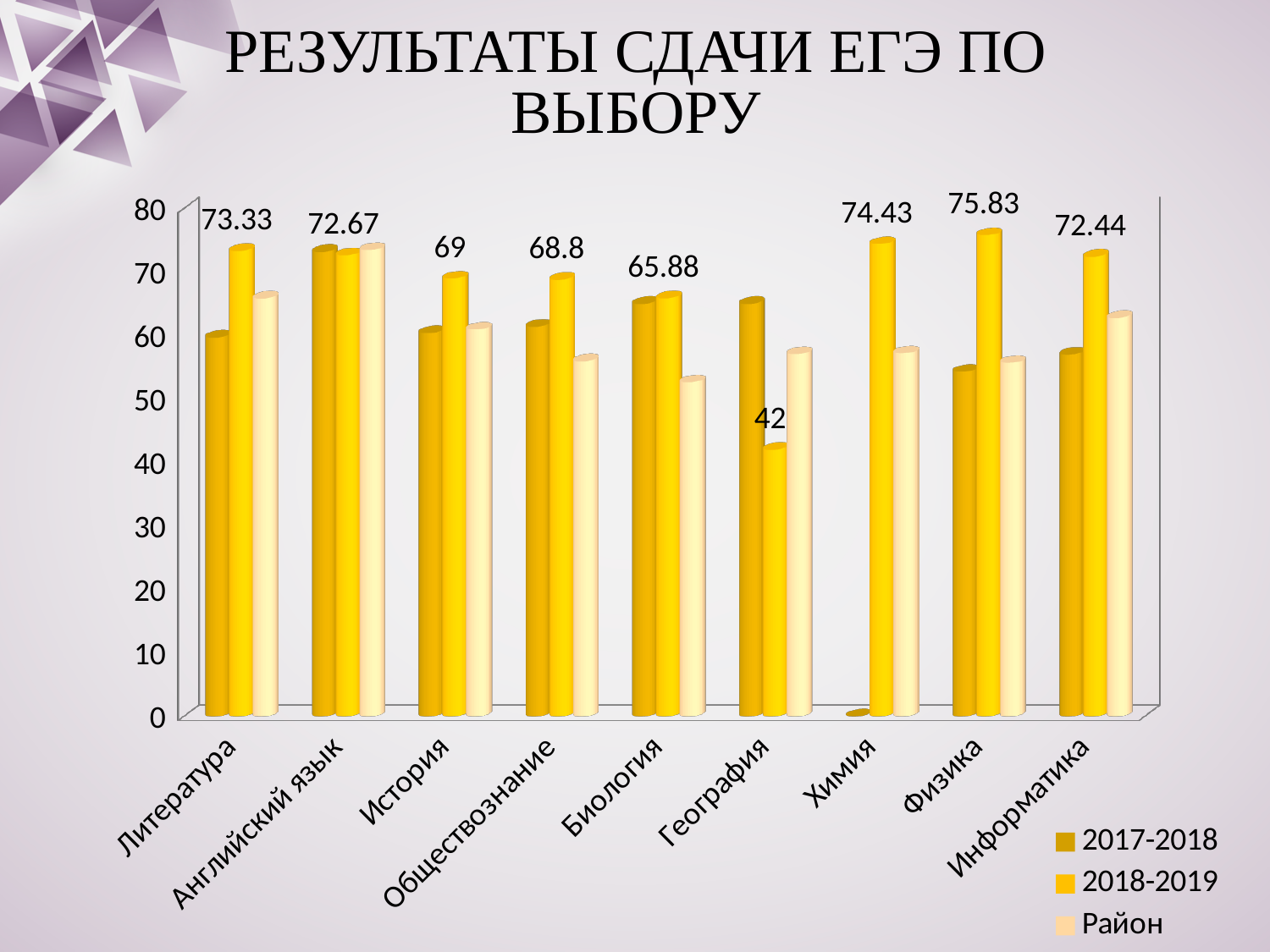
How many subjects are shown on the x axis? 9 How many series does the legend list? 3 What is the difference between the 2018-2019 values for Физика and География? 33.83 What kind of chart is shown on the slide? bar chart Which subject has the highest 2018-2019 value? Физика What is the 2018-2019 value for Литература? 73.33 What is the 2018-2019 value for Физика? 75.83 Which subject has the lowest 2018-2019 value? География Is the 2017-2018 value for Физика greater or less than 60? less What is the 2018-2019 value for География? 42 Is the 2017-2018 value for Английский язык greater or less than 70? greater Which is larger for 2018-2019: Химия or Информатика? Химия